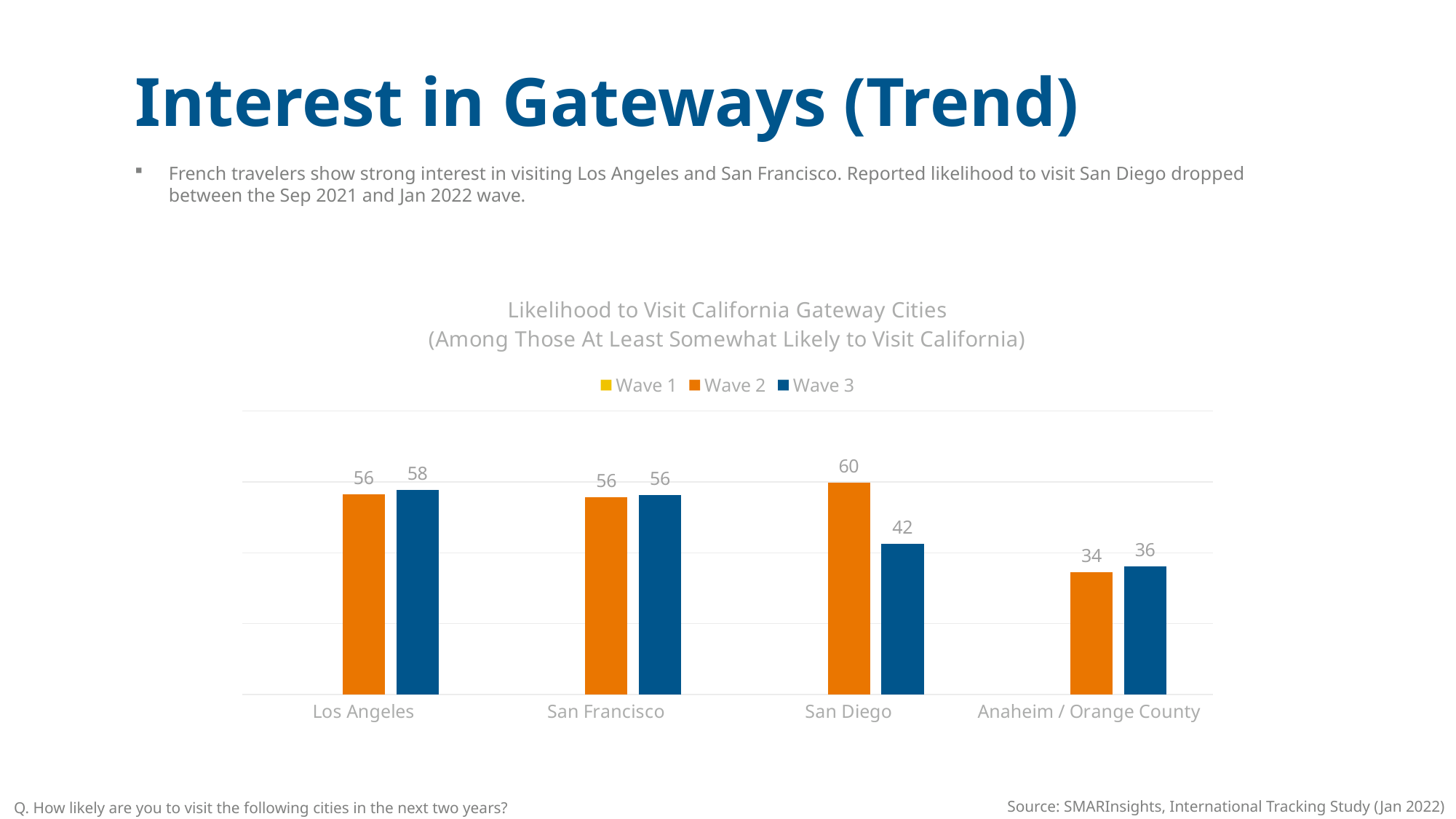
Which is larger for Los Angeles, the Wave 2 value or the Wave 3 value? Wave 3 What is the Wave 2 value for Los Angeles? 56 Which city has the lowest Wave 3 value? Anaheim / Orange County What is the Wave 3 value for Anaheim / Orange County? 36 What is the Wave 3 value for San Diego? 42 How many series does the legend list? 3 What kind of chart is shown? Bar chart Which series has no bars plotted in the chart? Wave 1 How many cities are shown on the x axis? 4 Which city has the highest Wave 2 value? San Diego What is the difference between the Wave 2 and Wave 3 values for San Diego? 18 What colour are the Wave 3 bars? Blue